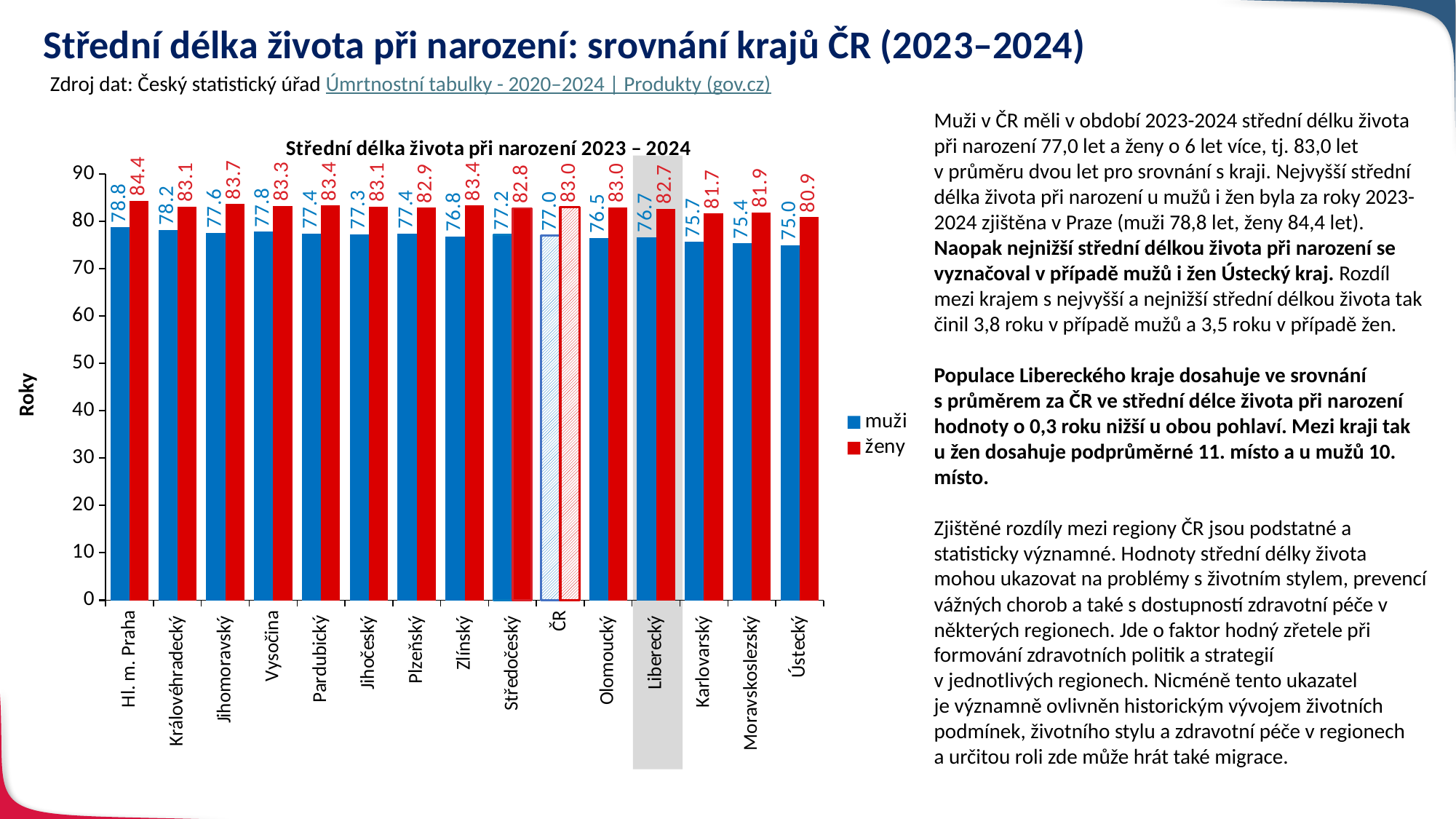
How many series does the legend list? 2 What is the label of the y axis? Roky What is the difference between the muži value for Hl. m. Praha and the muži value for Ústecký? 3.8 How many categories are shown on the x axis? 15 What kind of chart is shown? bar chart What is the value for muži in Hl. m. Praha? 78.8 What is the value for ženy in Liberecký? 82.7 Which is larger, the ženy value for Karlovarský or the ženy value for Moravskoslezský? Moravskoslezský Which category has the highest value for ženy? Hl. m. Praha What is the value for muži in Ústecký? 75.0 Which category has the lowest value for muži? Ústecký What is the difference between the ženy value and the muži value for ČR? 6.0